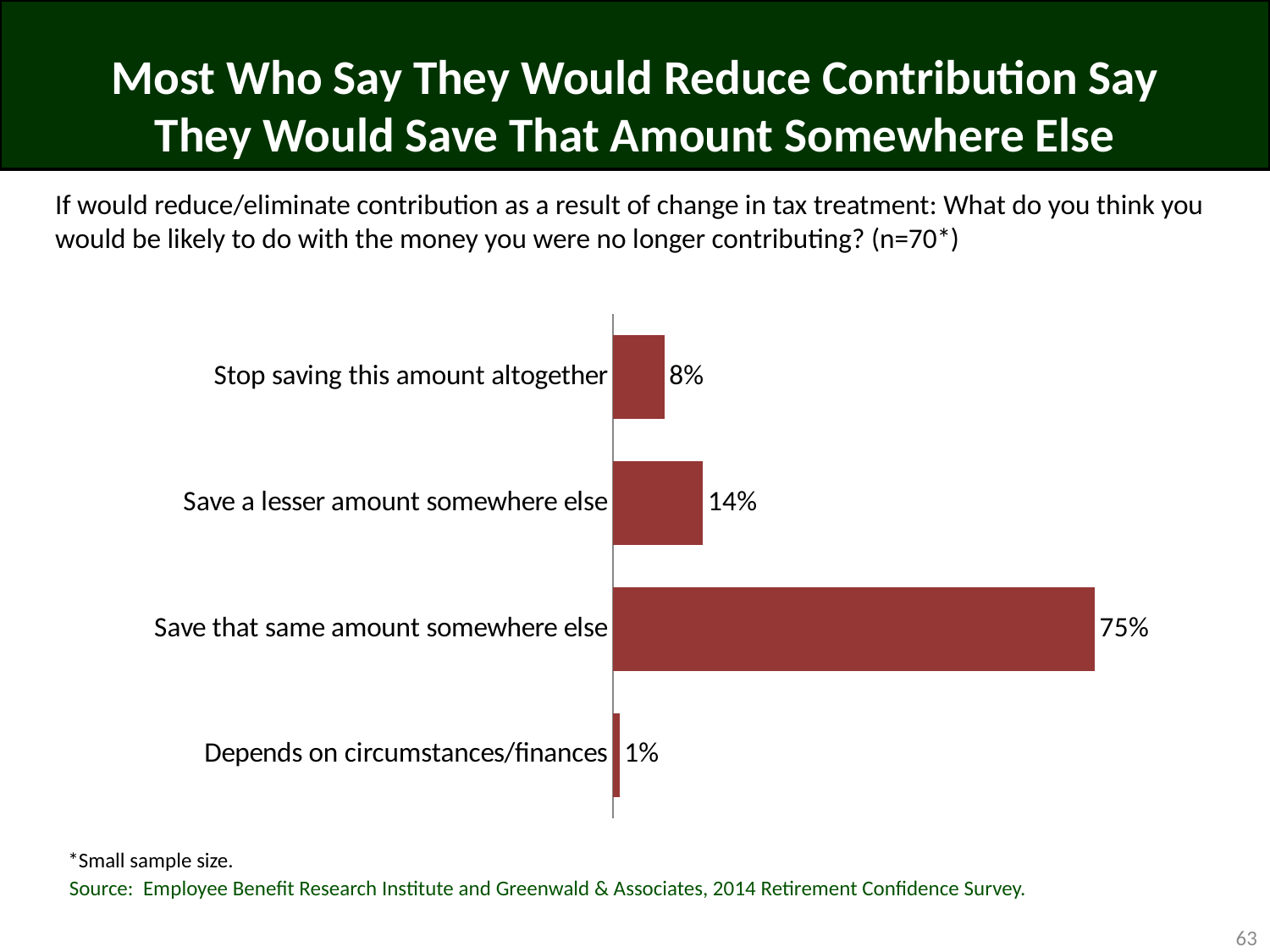
What type of chart is shown on the slide? Bar chart What percentage of respondents said it depends on circumstances/finances? 1% What percentage of respondents said they would stop saving this amount altogether? 8% How many response categories are shown in the chart? 4 Which is larger: the percentage for 'Stop saving this amount altogether' or for 'Save a lesser amount somewhere else'? Save a lesser amount somewhere else What is the sample size (n) noted in the question text above the chart? 70 Which response has the lowest percentage? Depends on circumstances/finances What percentage of respondents said they would save a lesser amount somewhere else? 14% Which response has the highest percentage? Save that same amount somewhere else What is the difference in percentage points between 'Save a lesser amount somewhere else' and 'Stop saving this amount altogether'? 6 What is the difference in percentage points between 'Save that same amount somewhere else' and 'Save a lesser amount somewhere else'? 61 What percentage of respondents said they would save that same amount somewhere else? 75%